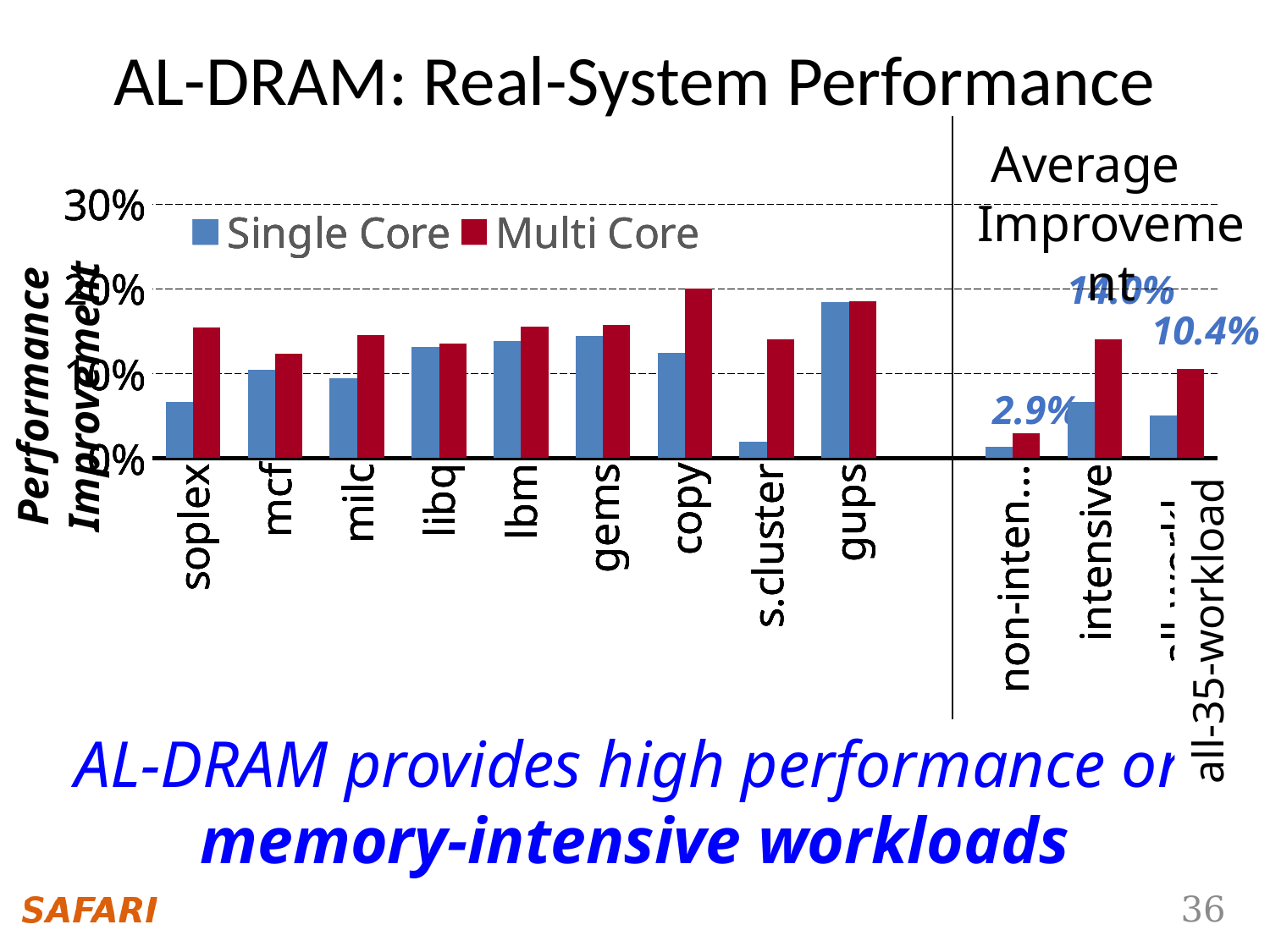
Which benchmark has the highest Single Core performance improvement? gups How many individual benchmark categories are plotted to the left of the vertical divider line? 9 What kind of chart is shown on the slide? bar chart Which colour represents the Multi Core series? red Is the Single Core performance improvement for s.cluster greater or less than 10%? less Which benchmark has the highest Multi Core performance improvement? copy How many series does the legend list? 2 Is the Single Core performance improvement for gups greater or less than 10%? greater What are the two series named in the legend? Single Core and Multi Core For soplex, which is larger: the Single Core or the Multi Core performance improvement? Multi Core Among the nine benchmarks left of the divider, which has the lowest Single Core performance improvement? s.cluster Which has the larger Single Core performance improvement: milc or libq? libq